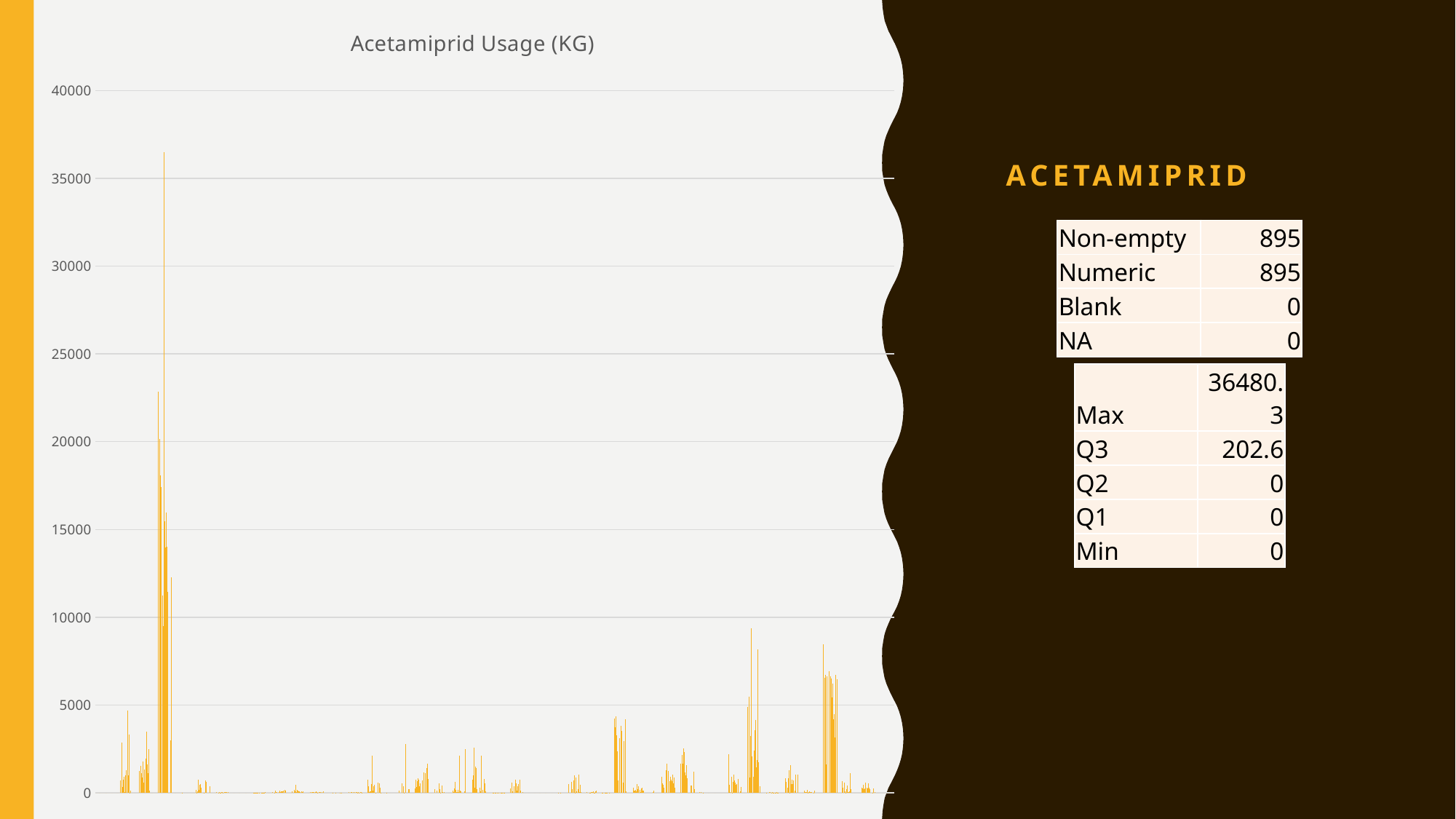
Is the tallest bar in the chart greater or less than 30000? greater What is the highest value shown on the chart's vertical axis? 40000 According to the statistics table on the slide, what is the Q3 value for Acetamiprid usage? 202.6 Is the tallest bar in the right-hand cluster of the chart (near the right edge) greater or less than 10000? less What is the title of the chart? Acetamiprid Usage (KG) According to the statistics table on the slide, how many numeric data points does the Acetamiprid usage series contain? 895 Is the tallest bar in the chart greater or less than 40000? less What kind of chart is shown on the slide? bar chart According to the statistics table on the slide, what is the maximum Acetamiprid usage value? 36480.3 According to the statistics table on the slide, what is the minimum Acetamiprid usage value? 0